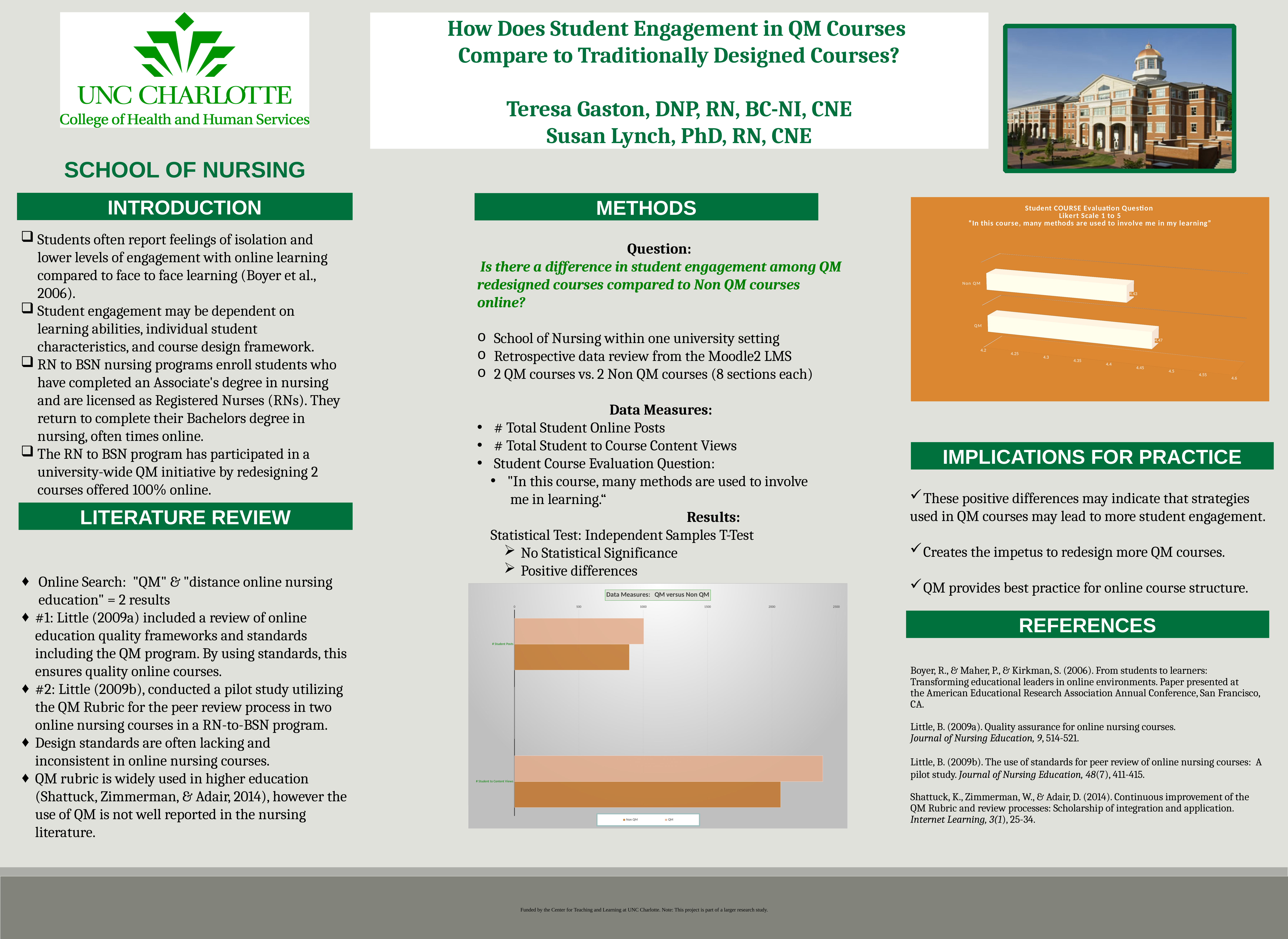
In the Student COURSE Evaluation Question chart at the top right, what is the value for Non QM? 4.43 In the chart titled "Data Measures: QM versus Non QM", which series has the larger value for # Student to Content Views, QM or Non QM? QM In the chart titled "Data Measures: QM versus Non QM", is the Non QM value for # Student Posts greater or less than 1000? less In the chart titled "Data Measures: QM versus Non QM", how many series does the legend list? 2 In the chart titled "Data Measures: QM versus Non QM", what are the two series named in the legend? Non QM and QM In the chart titled "Data Measures: QM versus Non QM", how many categories are plotted? 2 In the chart titled "Data Measures: QM versus Non QM", what kind of chart is shown? Bar chart In the chart titled "Data Measures: QM versus Non QM", is the Non QM value for # Student to Content Views greater or less than 1500? greater In the chart titled "Data Measures: QM versus Non QM", which category has the highest values, # Student Posts or # Student to Content Views? # Student to Content Views In the chart titled "Data Measures: QM versus Non QM", is the QM value for # Student to Content Views greater or less than 2000? greater In the Student COURSE Evaluation Question chart at the top right, how many categories are plotted? 2 In the Student COURSE Evaluation Question chart at the top right, what is the value for QM? 4.47